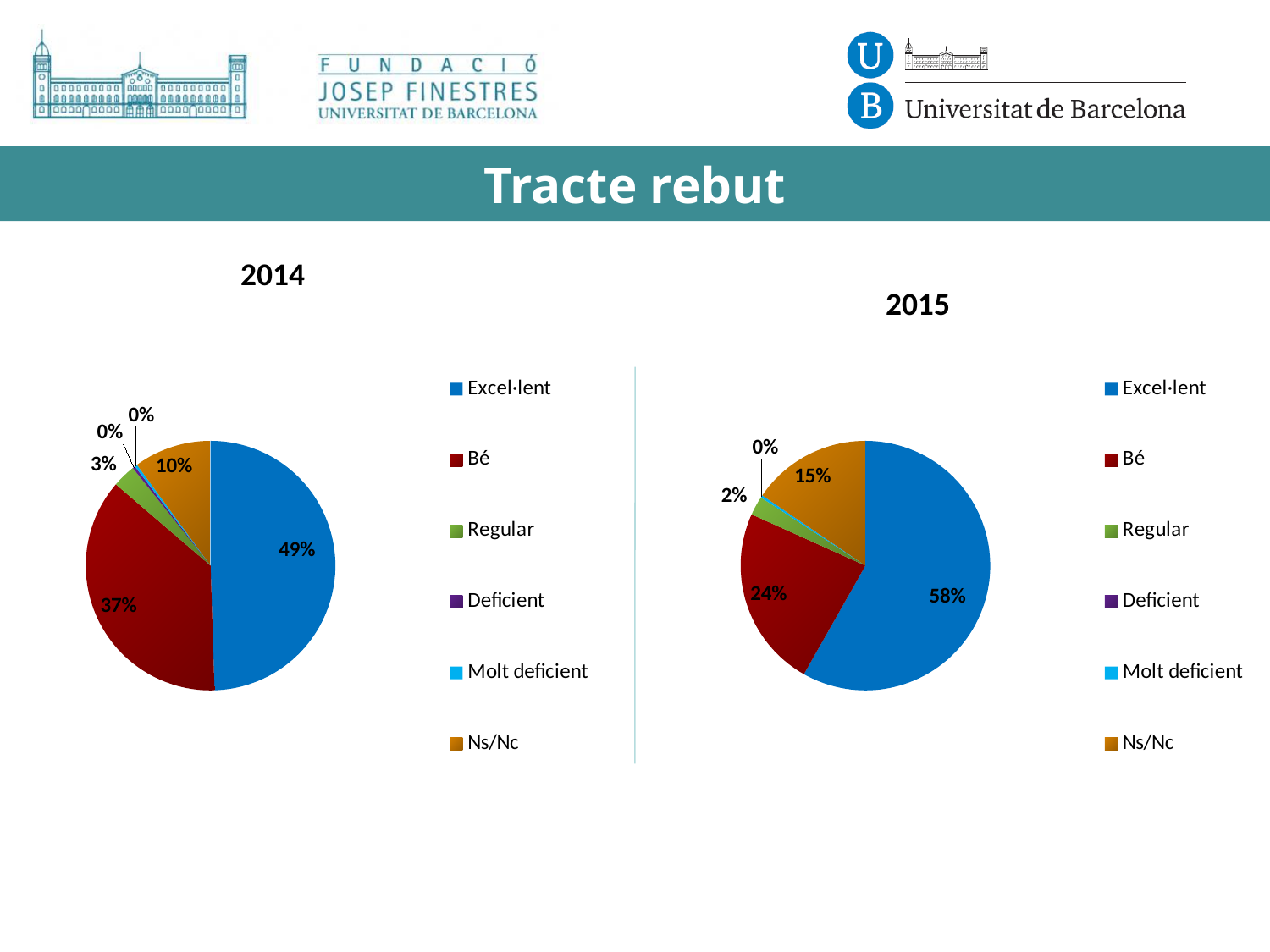
In the 2015 chart, which category has the largest slice? Excel·lent In the 2014 chart, what share does Bé have? 37% How many entries does the legend of the 2015 chart list? 6 In the 2014 chart, what share does Excel·lent have? 49% In the 2014 chart, what share does Regular have? 3% In the 2015 chart, what share does Ns/Nc have? 15% Which is larger: the Bé share in the 2014 chart or the Bé share in the 2015 chart? 2014 In the 2015 chart, what share does Excel·lent have? 58% What kind of chart is the 2014 chart? pie chart What is the difference between the Excel·lent share in the 2015 chart and the Excel·lent share in the 2014 chart? 9% In the 2015 chart, what share does Bé have? 24% In the 2014 chart, what share does Ns/Nc have? 10%